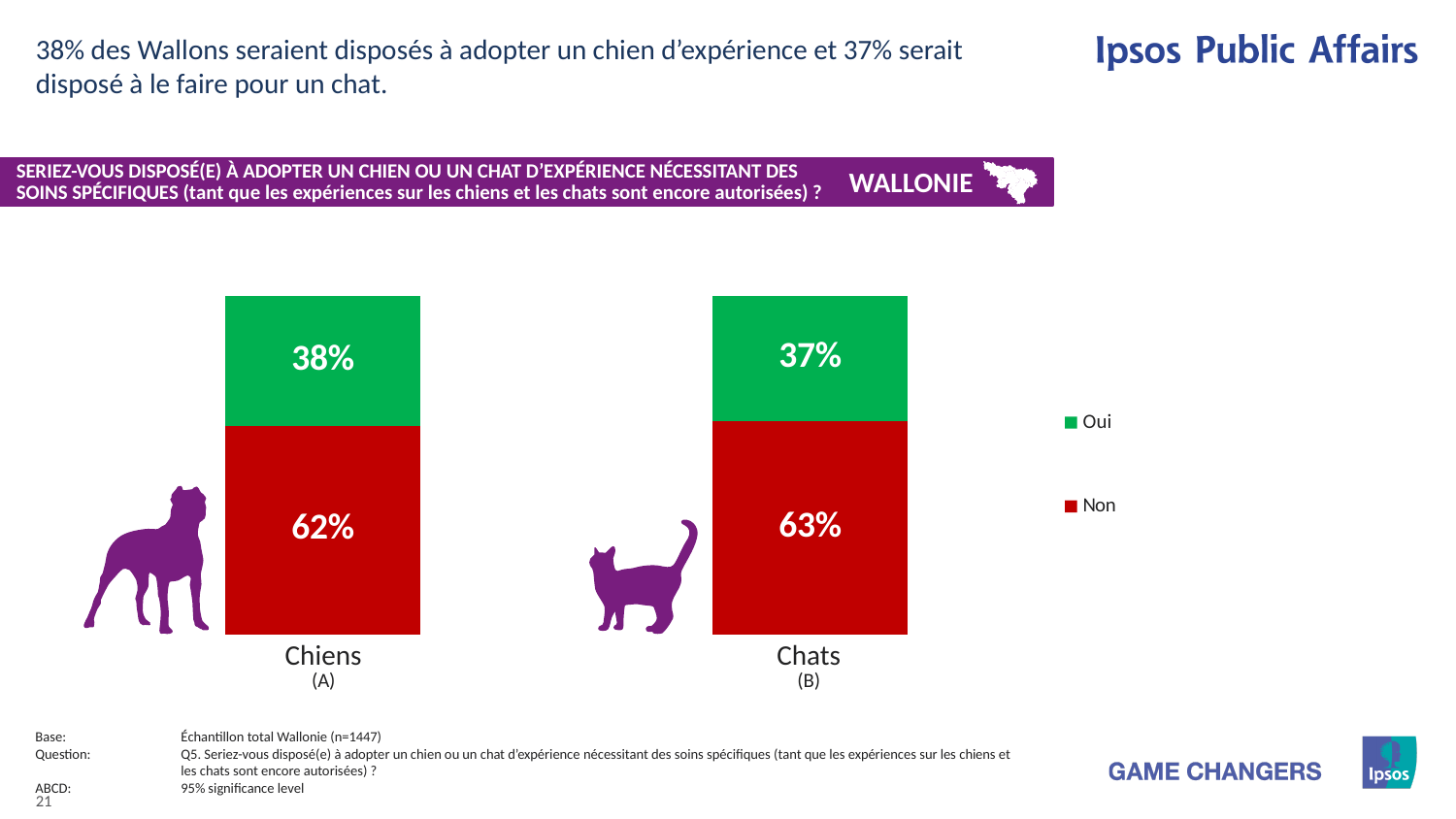
Which category has the higher 'Oui' share, Chiens or Chats? Chiens What kind of chart is shown on the slide? Stacked bar chart What percentage of respondents answered 'Non' for Chats? 63% What percentage of respondents answered 'Non' for Chiens? 62% Which category has the higher 'Non' share, Chiens or Chats? Chats What is the difference between the 'Non' and 'Oui' percentages for Chiens? 24% What is the total of the stacked bar for Chats? 100% How many series does the legend list? 2 What is the difference between the 'Non' and 'Oui' percentages for Chats? 26% What percentage of respondents answered 'Oui' for Chiens? 38% How many categories are shown on the x axis of the chart? 2 What percentage of respondents answered 'Oui' for Chats? 37%